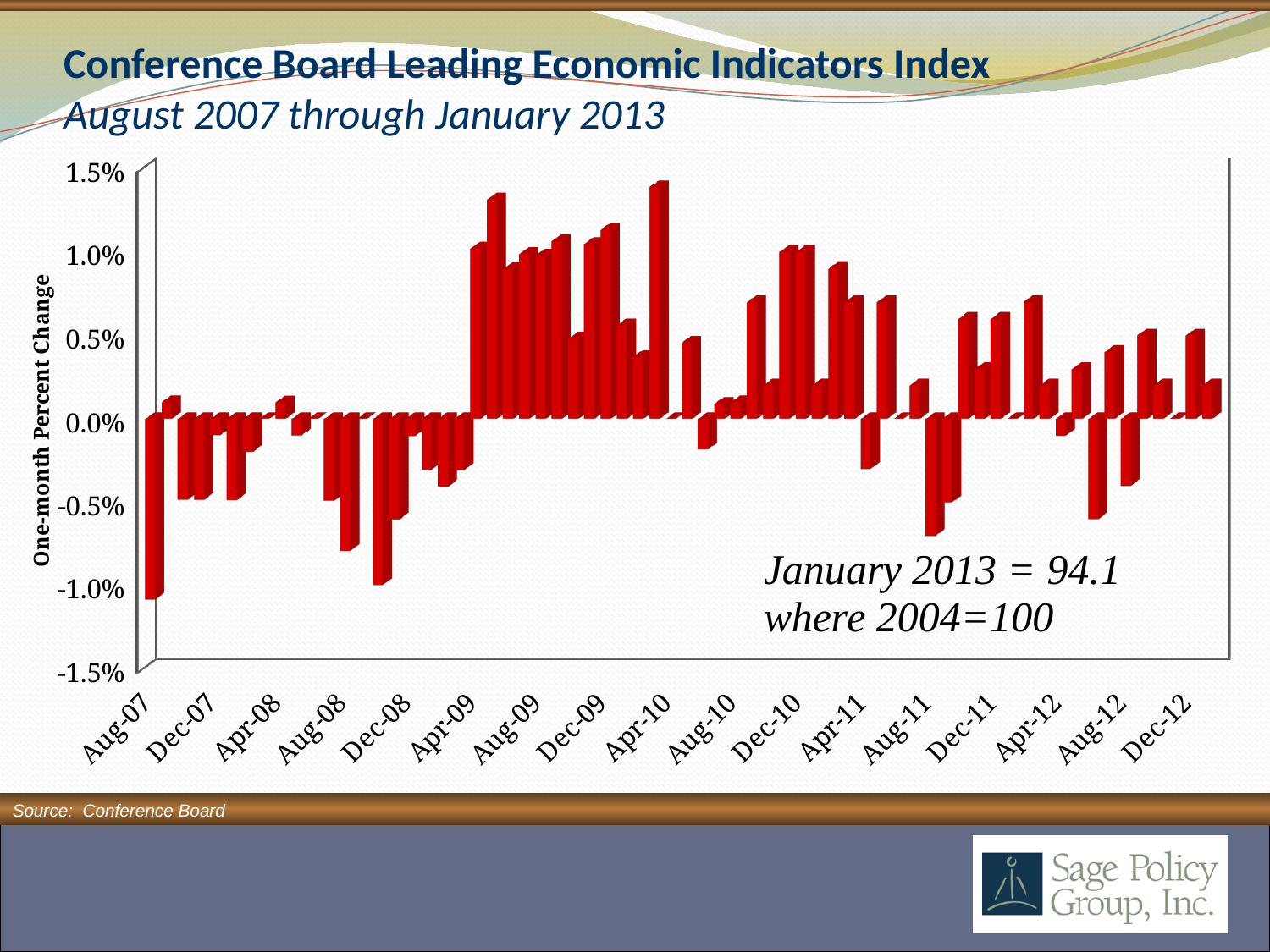
What is the label on the vertical axis of the chart? One-month Percent Change What is the title of the chart on the slide? Conference Board Leading Economic Indicators Index What base year equals 100 for the index, according to the chart annotation? 2004 What is the index value for January 2013 stated on the chart? 94.1 Is the value for Aug-07 greater or less than -0.5%? less What kind of chart is shown on the slide? Bar chart How many month labels are shown along the x axis? 17 Is the value for Aug-07 positive or negative? negative What is the source cited for the chart? Conference Board Is the highest bar on the chart greater or less than 1.0%? greater What period does the chart cover, according to the subtitle? August 2007 through January 2013 What are the minimum and maximum values shown on the vertical axis? -1.5% and 1.5%